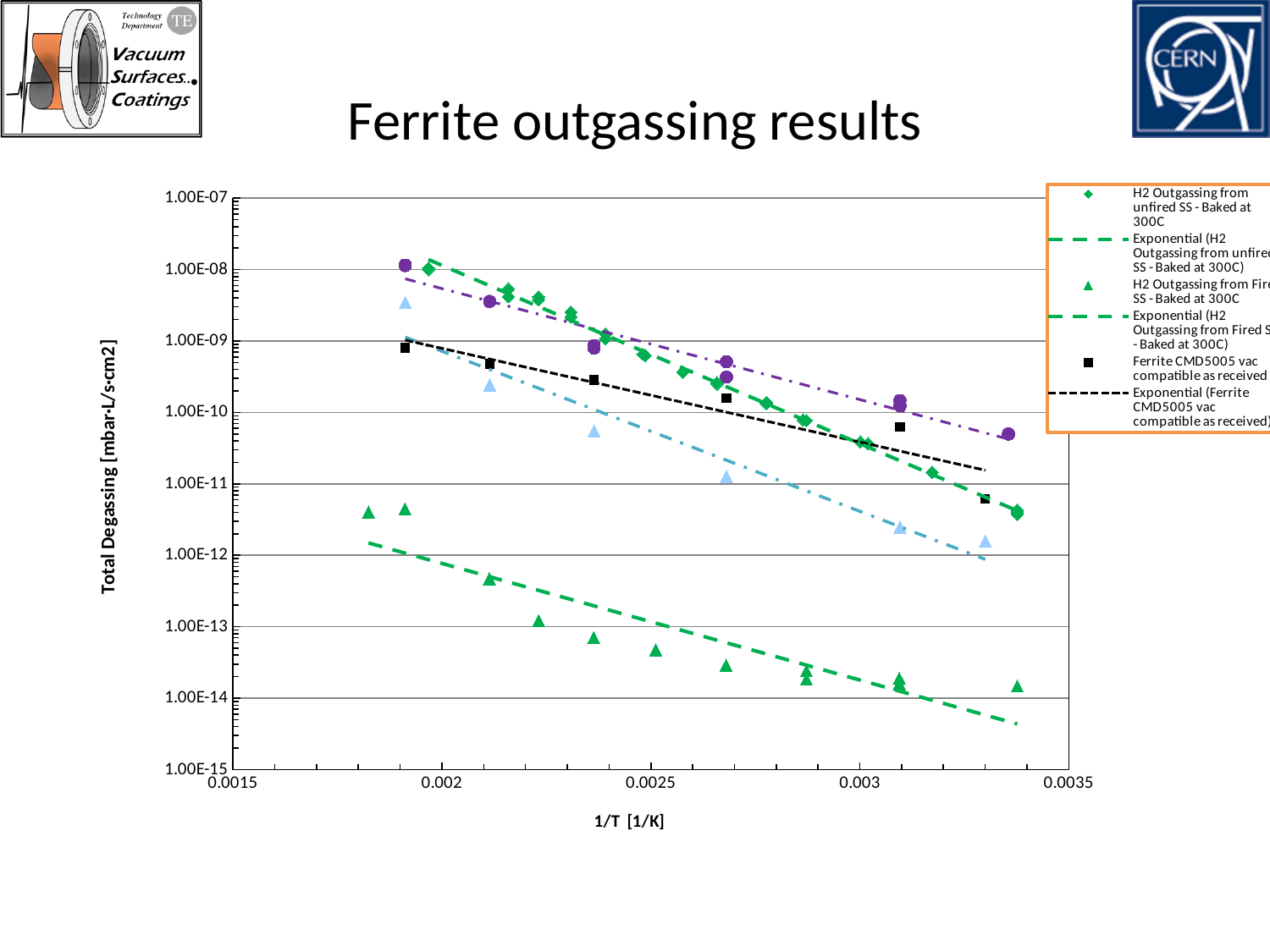
As 1/T increases along the x-axis, do the Ferrite CMD5005 vac compatible as received values rise or fall? Fall Are all the H2 Outgassing from Fired SS - Baked at 300C values greater or less than 1.00E-11? Less Is the Ferrite CMD5005 vac compatible as received value at the largest 1/T greater or less than 1.00E-11? Less What is the title of the slide's chart? Ferrite outgassing results Is the lowest H2 Outgassing from Fired SS - Baked at 300C value greater or less than 1.00E-13? Less What is the maximum value shown on the y-axis? 1.00E-07 What kind of chart is shown on the slide? Scatter chart What is the label of the y-axis? Total Degassing [mbar·L/s·cm2] Which series has higher values overall: H2 Outgassing from unfired SS - Baked at 300C or H2 Outgassing from Fired SS - Baked at 300C? H2 Outgassing from unfired SS - Baked at 300C As 1/T increases along the x-axis, do the H2 Outgassing from unfired SS values rise or fall? Fall